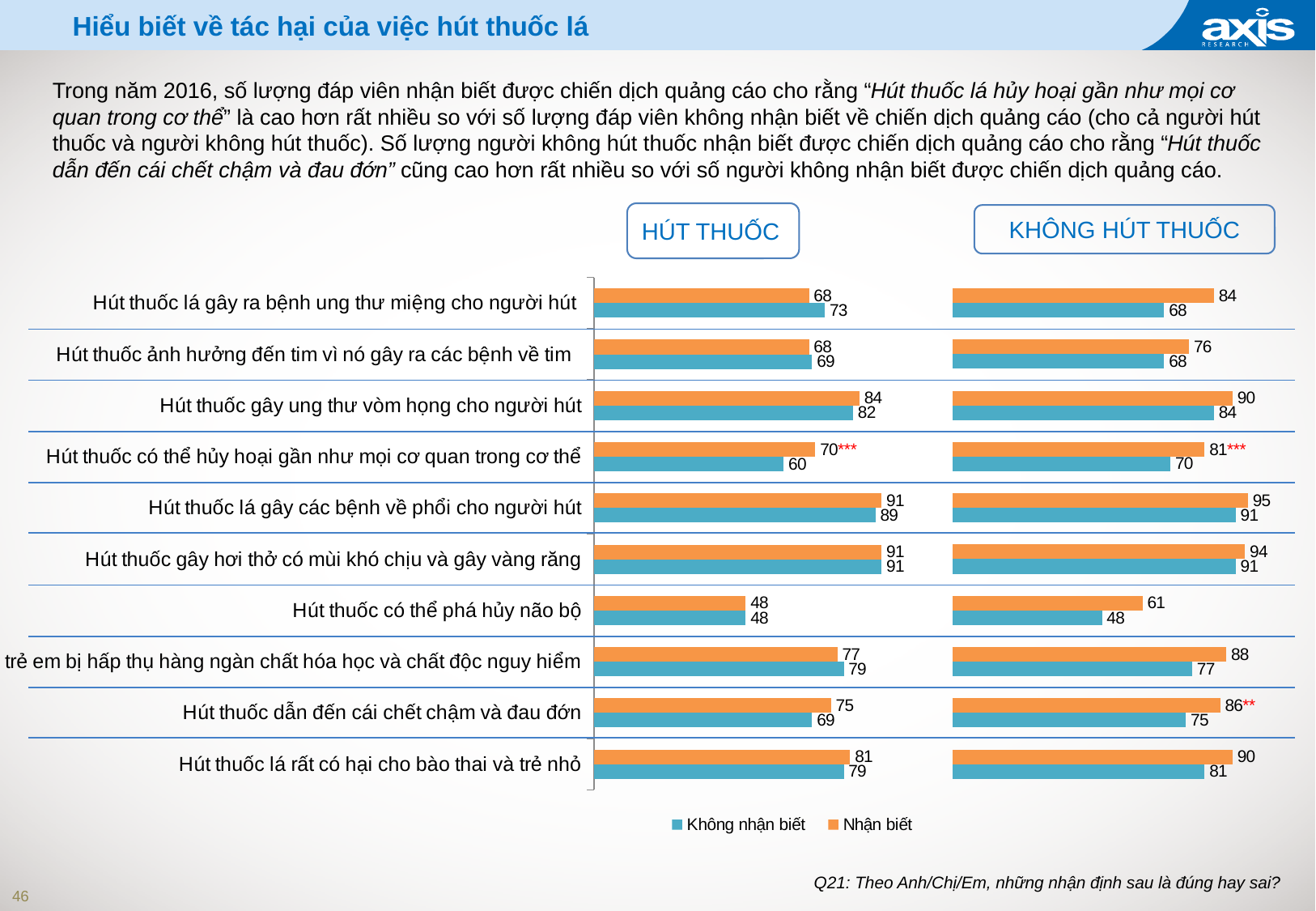
In the KHÔNG HÚT THUỐC chart, what is the difference between Nhận biết and Không nhận biết for "Hút thuốc lá gây ra bệnh ung thư miệng cho người hút"? 16 In the HÚT THUỐC chart, for "Hút thuốc lá gây ra bệnh ung thư miệng cho người hút", which is larger: Nhận biết or Không nhận biết? Không nhận biết In the KHÔNG HÚT THUỐC chart, what is the value of Không nhận biết for "Hút thuốc lá gây ra bệnh ung thư miệng cho người hút"? 68 In the KHÔNG HÚT THUỐC chart, what is the value of Nhận biết for "Hút thuốc lá gây các bệnh về phổi cho người hút"? 95 In the KHÔNG HÚT THUỐC chart, which category has the highest Nhận biết value? Hút thuốc lá gây các bệnh về phổi cho người hút In the HÚT THUỐC chart, which category has the lowest Nhận biết value? Hút thuốc có thể phá hủy não bộ What type of chart is used for the HÚT THUỐC data? Bar chart How many categories are shown in the KHÔNG HÚT THUỐC chart? 10 In the HÚT THUỐC chart, what is the difference between Nhận biết and Không nhận biết for "Hút thuốc dẫn đến cái chết chậm và đau đớn"? 6 In the HÚT THUỐC chart, for "Hút thuốc có thể hủy hoại gần như mọi cơ quan trong cơ thể", which is larger: Nhận biết or Không nhận biết? Nhận biết In the HÚT THUỐC chart, what is the value of Nhận biết for "Hút thuốc có thể phá hủy não bộ"? 48 How many series does the legend list? 2